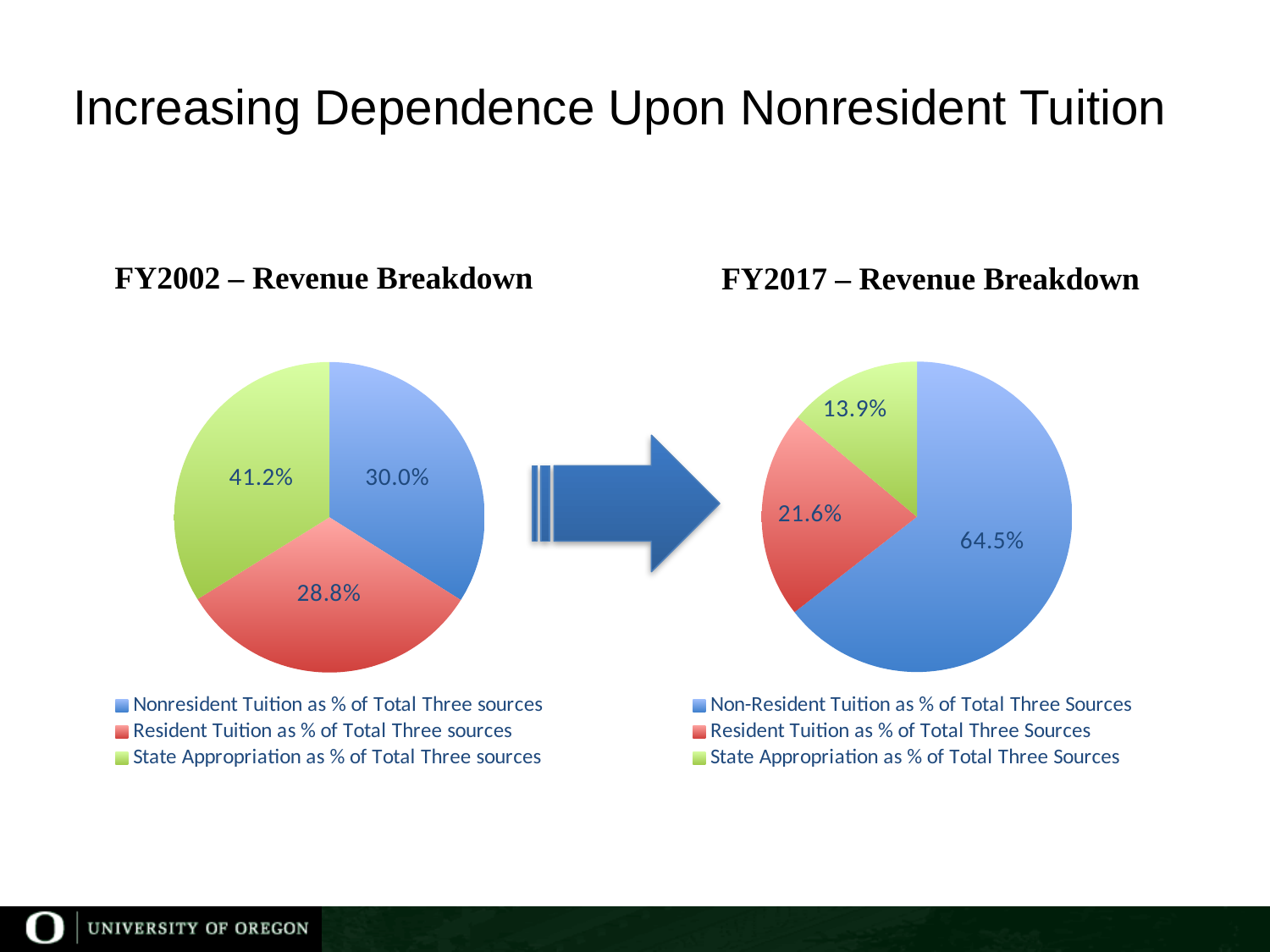
In the FY2002 – Revenue Breakdown chart, what is the difference between the State Appropriation and Nonresident Tuition slices? 11.2% In the FY2002 – Revenue Breakdown chart, which category has the largest slice? State Appropriation as % of Total Three sources In the FY2002 – Revenue Breakdown chart, what is the value for Nonresident Tuition as % of Total Three sources? 30.0% In the FY2017 – Revenue Breakdown chart, which category has the smallest slice? State Appropriation as % of Total Three Sources In the FY2002 – Revenue Breakdown chart, which is larger: Nonresident Tuition or Resident Tuition? Nonresident Tuition In the FY2017 – Revenue Breakdown chart, what is the difference between the Non-Resident Tuition and Resident Tuition slices? 42.9% In the FY2017 – Revenue Breakdown chart, what is the value for Resident Tuition as % of Total Three Sources? 21.6% In the FY2002 – Revenue Breakdown chart, which category has the smallest slice? Resident Tuition as % of Total Three sources How many slices does the FY2017 – Revenue Breakdown chart have? 3 What kind of chart is the FY2002 – Revenue Breakdown chart? Pie chart In the FY2017 – Revenue Breakdown chart, what colour is the Non-Resident Tuition slice? Blue In the FY2017 – Revenue Breakdown chart, what is the value for State Appropriation as % of Total Three Sources? 13.9%